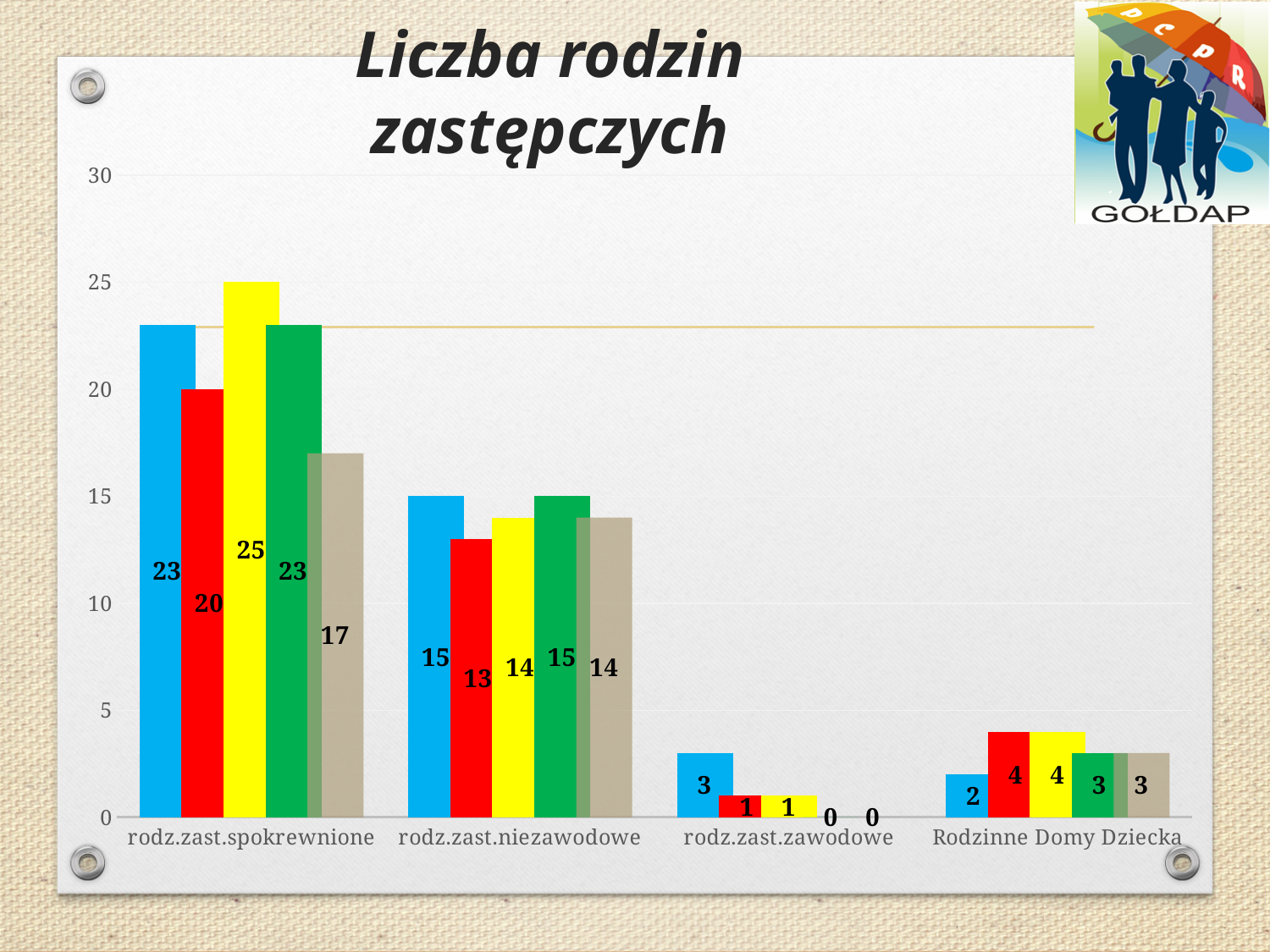
What is the difference between the yellow bar and the tan (beige) bar for rodz.zast.spokrewnione? 8 What is the value of the tan (beige) bar for rodz.zast.spokrewnione? 17 What is the value of the blue bar for Rodzinne Domy Dziecka? 2 How many bars are shown for each category in the chart? 5 How many categories are shown on the x axis of the chart? 4 What is the value of the red bar for rodz.zast.niezawodowe? 13 Which is larger for rodz.zast.niezawodowe: the blue bar or the red bar? the blue bar What is the value of the yellow bar for rodz.zast.spokrewnione? 25 What is the title of the chart? Liczba rodzin zastępczych What kind of chart is shown on the slide? bar chart Which category has the highest bar in the chart? rodz.zast.spokrewnione What is the value of the blue bar for rodz.zast.zawodowe? 3